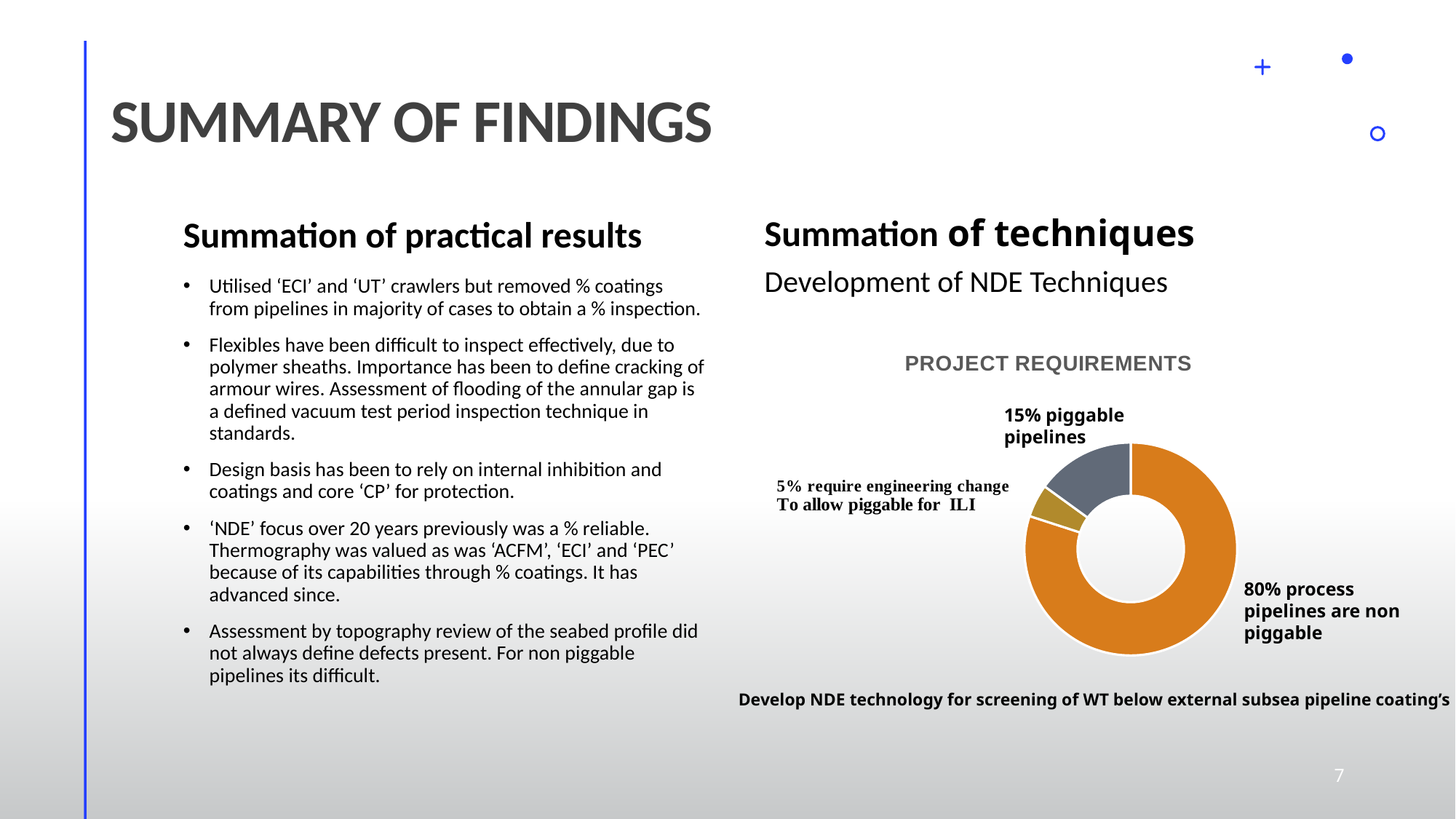
What kind of chart is shown under 'PROJECT REQUIREMENTS'? Pie chart (doughnut) Which slice of the 'PROJECT REQUIREMENTS' chart is the smallest? 5% require engineering change to allow piggable for ILI What colour is the largest slice in the 'PROJECT REQUIREMENTS' chart? Orange What share of the 'PROJECT REQUIREMENTS' chart is labelled as requiring engineering change to allow piggable for ILI? 5% What is the title of the chart on the slide? PROJECT REQUIREMENTS In the 'PROJECT REQUIREMENTS' chart, which is larger: the share of piggable pipelines or the share requiring engineering change? Piggable pipelines (15%) How many slices does the 'PROJECT REQUIREMENTS' chart have? 3 Which slice of the 'PROJECT REQUIREMENTS' chart is the largest? 80% process pipelines are non piggable In the 'PROJECT REQUIREMENTS' chart, what is the difference between the share of non piggable process pipelines and the share of piggable pipelines? 65% What share of the 'PROJECT REQUIREMENTS' chart is labelled as piggable pipelines? 15% In the 'PROJECT REQUIREMENTS' chart, what is the combined share of piggable pipelines and those requiring engineering change? 20% What share of the 'PROJECT REQUIREMENTS' chart is labelled as process pipelines that are non piggable? 80%